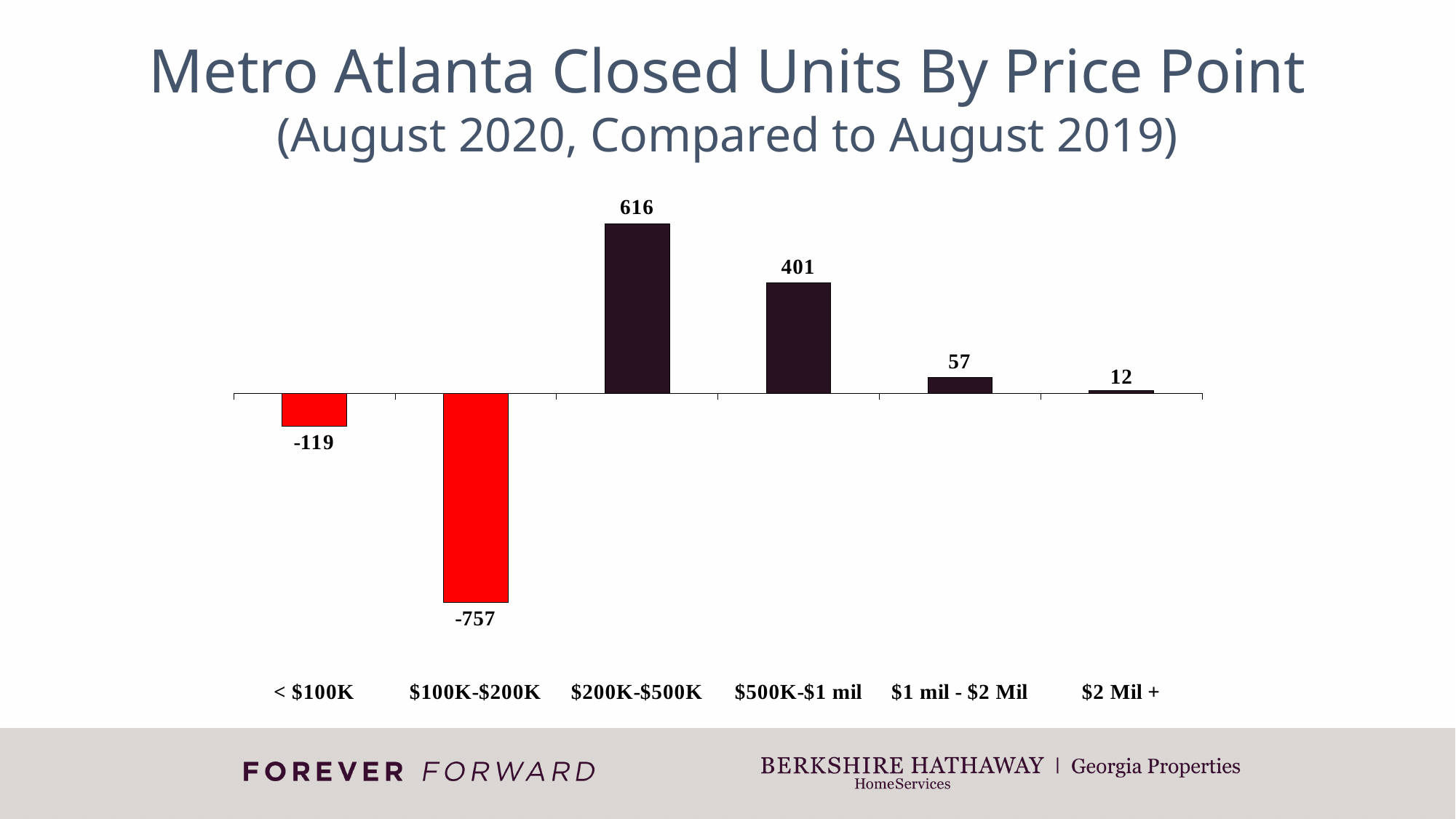
What is the value for the < $100K price point? -119 How many price point categories are shown in the chart? 6 How many price points have a negative value? 2 Which is larger, the value for $500K-$1 mil or the value for $1 mil - $2 Mil? $500K-$1 mil What is the value for the $100K-$200K price point? -757 What is the difference between the values for $200K-$500K and $500K-$1 mil? 215 What is the value for the $200K-$500K price point? 616 Which price point has the highest value? $200K-$500K Which price point has the lowest value? $100K-$200K What is the value for the $2 Mil + price point? 12 What colour are the bars with negative values? Red What kind of chart is shown on the slide? Bar chart